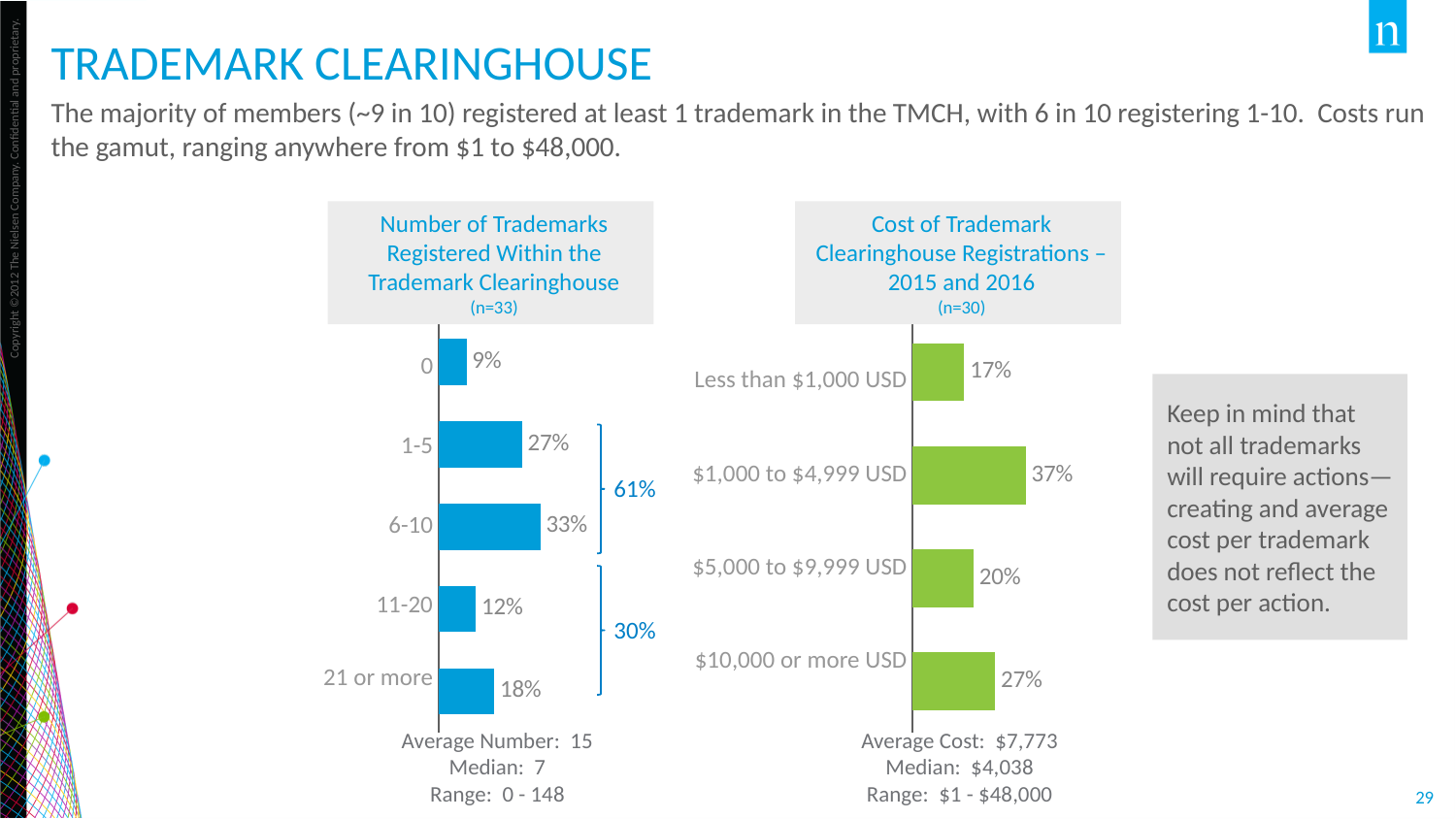
In the 'Number of Trademarks Registered Within the Trademark Clearinghouse' chart, what is the difference between the percentages for 1-5 and 11-20? 15% What is the sample size (n) shown for the 'Number of Trademarks Registered Within the Trademark Clearinghouse' chart? n=33 In the 'Cost of Trademark Clearinghouse Registrations – 2015 and 2016' chart, what percentage paid $1,000 to $4,999 USD? 37% In the 'Cost of Trademark Clearinghouse Registrations – 2015 and 2016' chart, what is the difference between the percentages for $1,000 to $4,999 USD and Less than $1,000 USD? 20% In the 'Number of Trademarks Registered Within the Trademark Clearinghouse' chart, what percentage of members registered 6-10 trademarks? 33% In the 'Cost of Trademark Clearinghouse Registrations – 2015 and 2016' chart, which is larger: $5,000 to $9,999 USD or $10,000 or more USD? $10,000 or more USD In the 'Number of Trademarks Registered Within the Trademark Clearinghouse' chart, which category has the lowest percentage? 0 What type of chart is the 'Cost of Trademark Clearinghouse Registrations – 2015 and 2016' chart? Bar chart What is the average cost shown below the 'Cost of Trademark Clearinghouse Registrations – 2015 and 2016' chart? $7,773 In the 'Number of Trademarks Registered Within the Trademark Clearinghouse' chart, how many categories are shown? 5 In the 'Number of Trademarks Registered Within the Trademark Clearinghouse' chart, which category has the highest percentage? 6-10 In the 'Cost of Trademark Clearinghouse Registrations – 2015 and 2016' chart, which cost category has the lowest percentage? Less than $1,000 USD